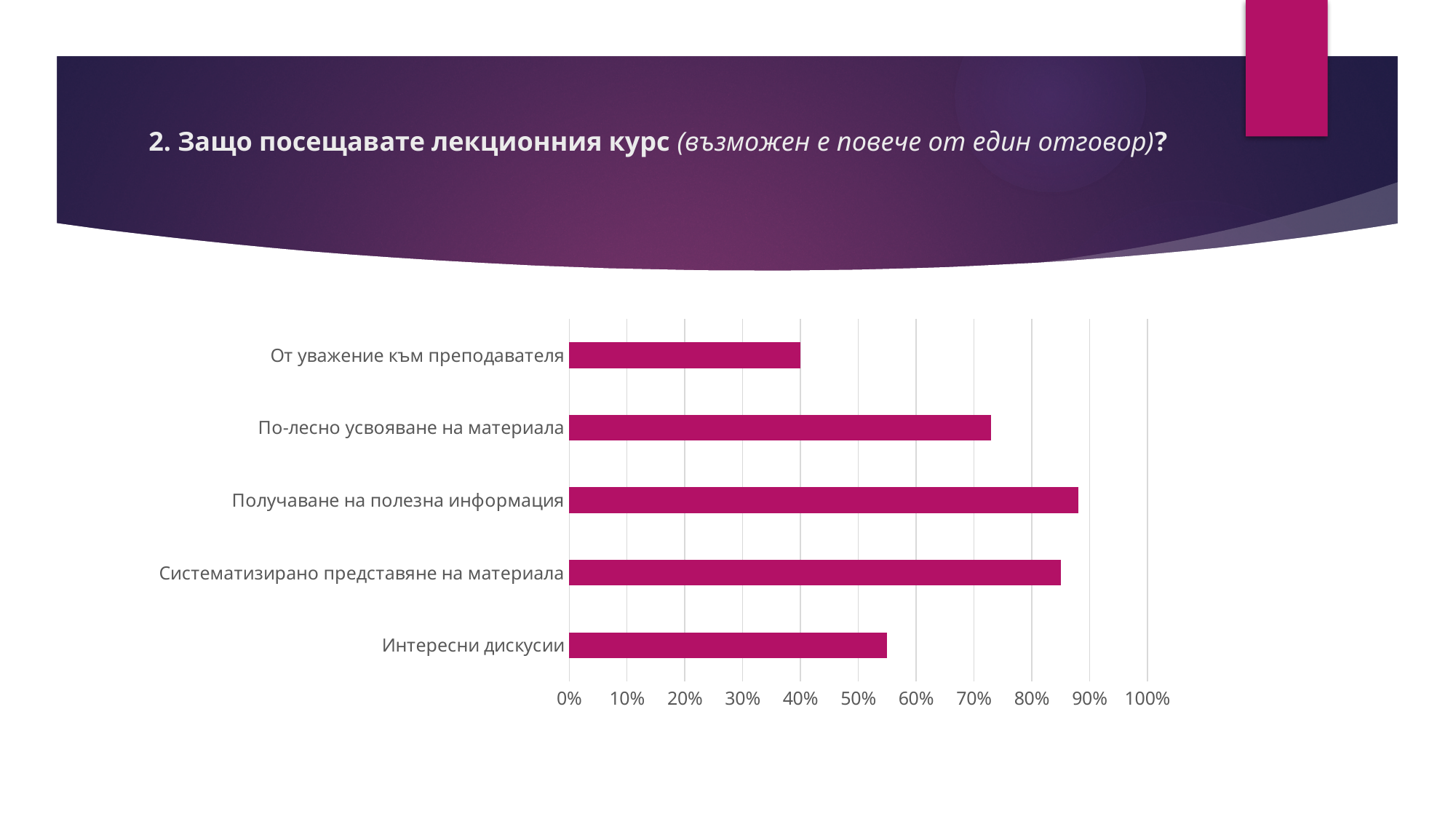
What colour are the bars in the chart? magenta Which is larger: the value for По-лесно усвояване на материала or the value for Интересни дискусии? По-лесно усвояване на материала What is the highest value shown on the horizontal axis? 100% Is the value for Получаване на полезна информация greater or less than 80%? greater How many categories does the chart show? 5 Which category has the lowest value? От уважение към преподавателя Is the value for Интересни дискусии greater or less than 50%? greater What kind of chart is shown on the slide? bar chart Which category has the highest value? Получаване на полезна информация Is the value for По-лесно усвояване на материала greater or less than 70%? greater